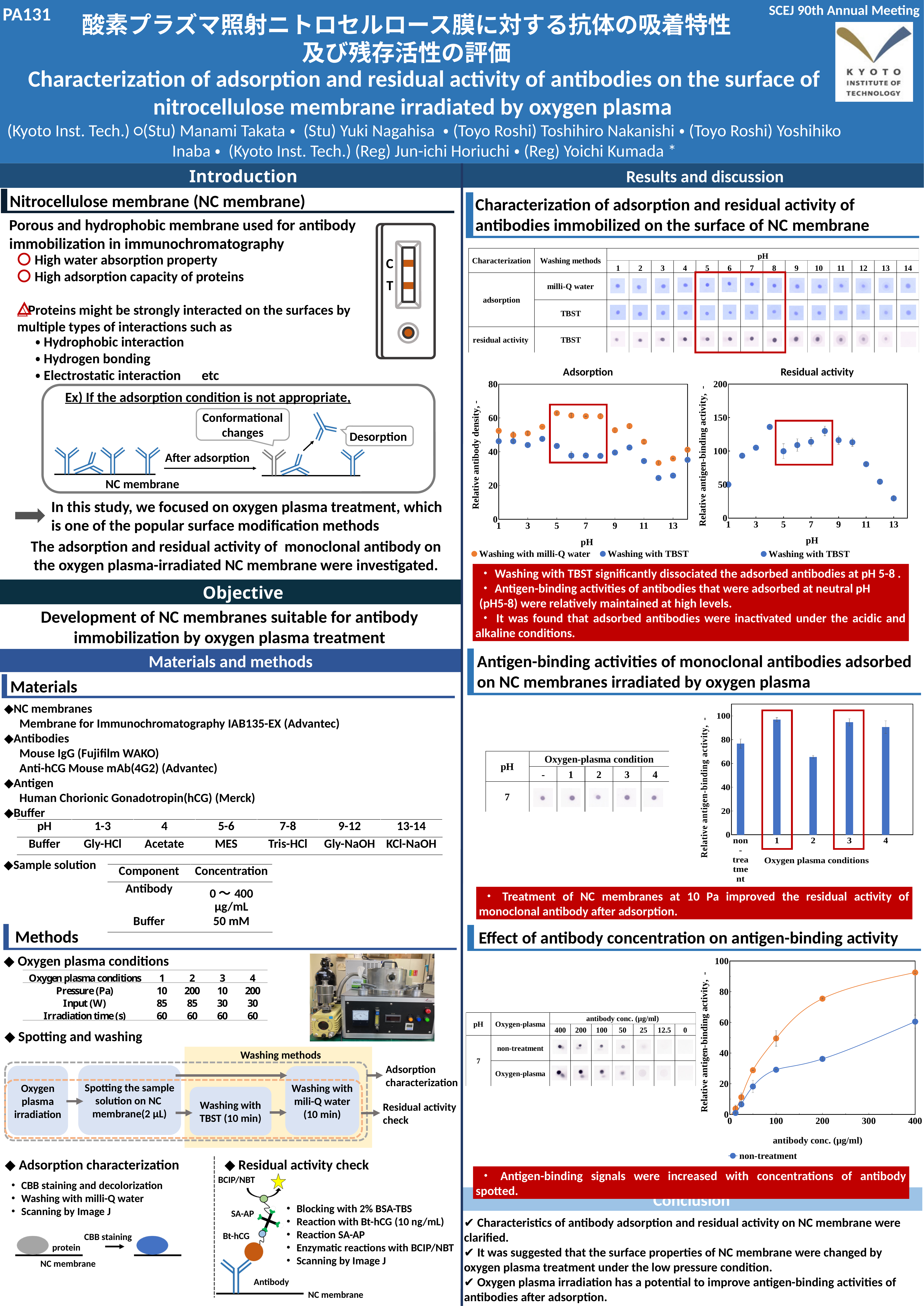
In the 'Adsorption' chart, at pH 6, which series has the larger value: washing with milli-Q water or washing with TBST? Washing with milli-Q water In the 'Adsorption' chart, what are the two legend entries? Washing with milli-Q water; Washing with TBST In the 'Residual activity' chart, do the values rise or fall from pH 9 to pH 13? fall In the 'Adsorption' chart, is the value for washing with TBST at pH 12 greater or less than 40? less In the bar chart of relative antigen-binding activity versus oxygen plasma conditions, which condition has the lowest value? 2 In the 'Residual activity' chart, how many series does the legend list? 1 In the chart of relative antigen-binding activity versus antibody concentration, what kind of chart is it? line chart In the 'Adsorption' chart, how many series does the legend list? 2 In the bar chart of relative antigen-binding activity versus oxygen plasma conditions, how many bars are plotted? 5 In the bar chart of relative antigen-binding activity versus oxygen plasma conditions, is the value for non-treatment greater or less than 60? greater In the 'Residual activity' chart, is the value at pH 4 greater or less than 100? greater